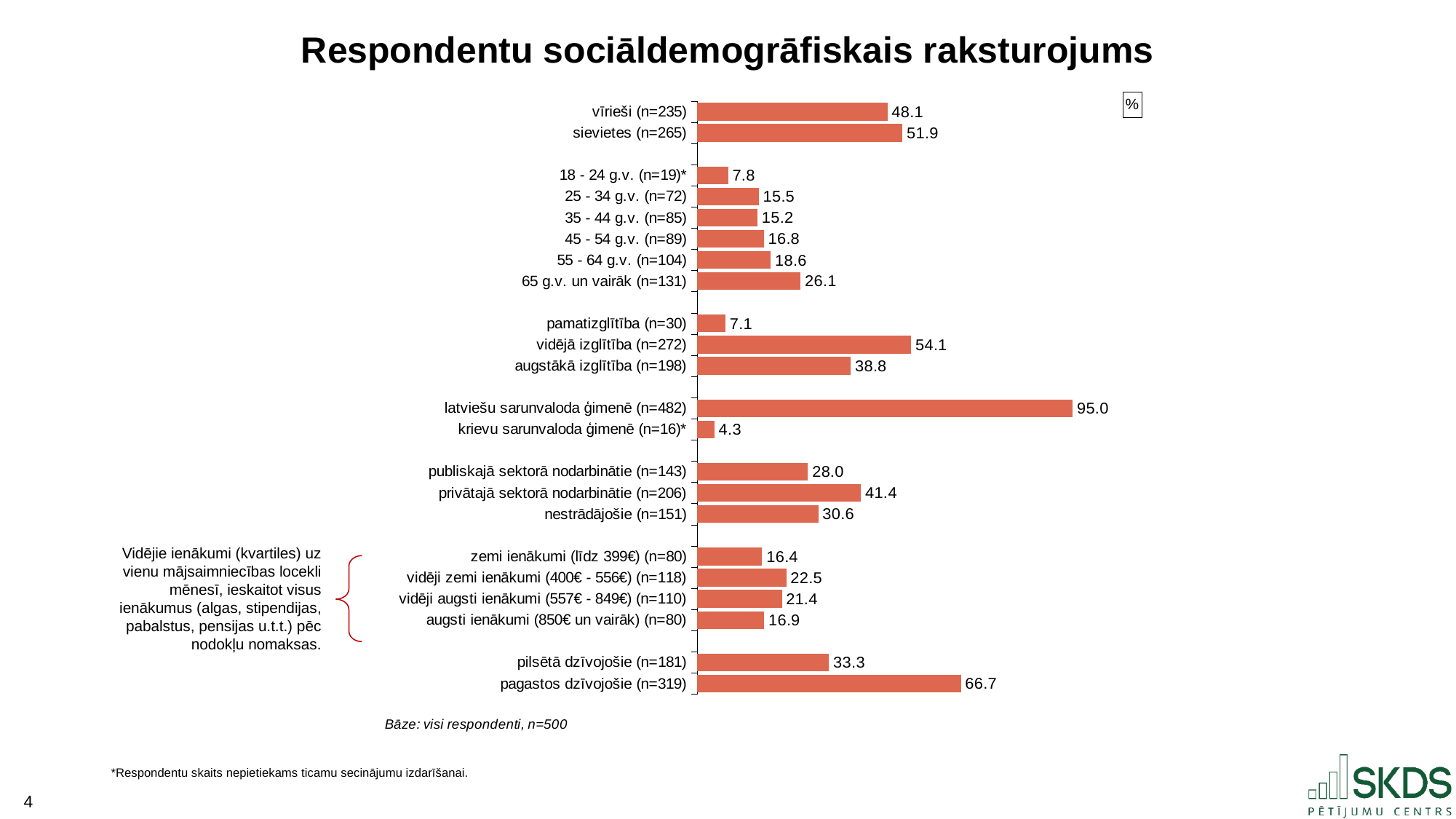
What is the value for 65 g.v. un vairāk (n=131)? 26.1 What is the difference between pagastos dzīvojošie (n=319) and pilsētā dzīvojošie (n=181)? 33.4 Which category has the highest value? latviešu sarunvaloda ģimenē (n=482) Which category has the lowest value? krievu sarunvaloda ģimenē (n=16)* How many bars are plotted in the chart? 22 What is the value for privātajā sektorā nodarbinātie (n=206)? 41.4 What is the value for sievietes (n=265)? 51.9 What is the value for vidēji zemi ienākumi (400€ - 556€) (n=118)? 22.5 What is the title of the chart? Respondentu sociāldemogrāfiskais raksturojums Which is larger, the value for 25 - 34 g.v. (n=72) or 35 - 44 g.v. (n=85)? 25 - 34 g.v. (n=72) What is the difference between vidējā izglītība (n=272) and augstākā izglītība (n=198)? 15.3 What kind of chart is shown on the slide? bar chart